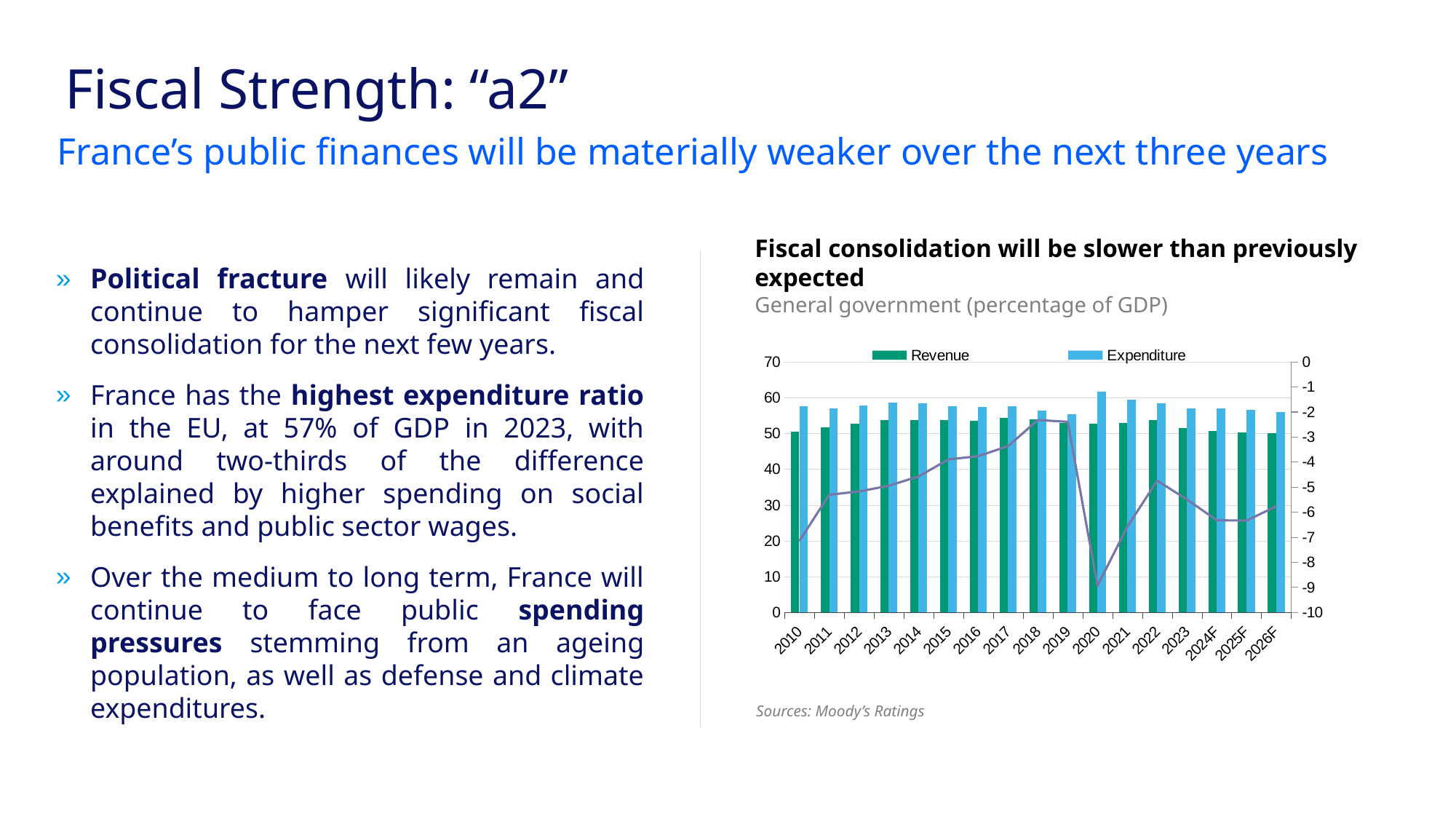
Which is larger, the Expenditure value for 2020 or the Expenditure value for 2019? 2020 In 2020, which is larger, Revenue or Expenditure? Expenditure What is the title of the chart? Fiscal consolidation will be slower than previously expected How many years are shown on the x axis of the chart? 17 Which year has the highest Expenditure bar? 2020 What kind of chart is shown on the slide? combination bar and line chart How many series does the chart's legend list? 2 What colour are the Revenue bars in the chart? green Is the Revenue value for 2010 greater or less than 60? less Do the Expenditure bars rise or fall from 2020 to 2026F? fall Is the Expenditure value for 2010 greater or less than 50? greater Is the Expenditure value for 2020 greater or less than 60? greater